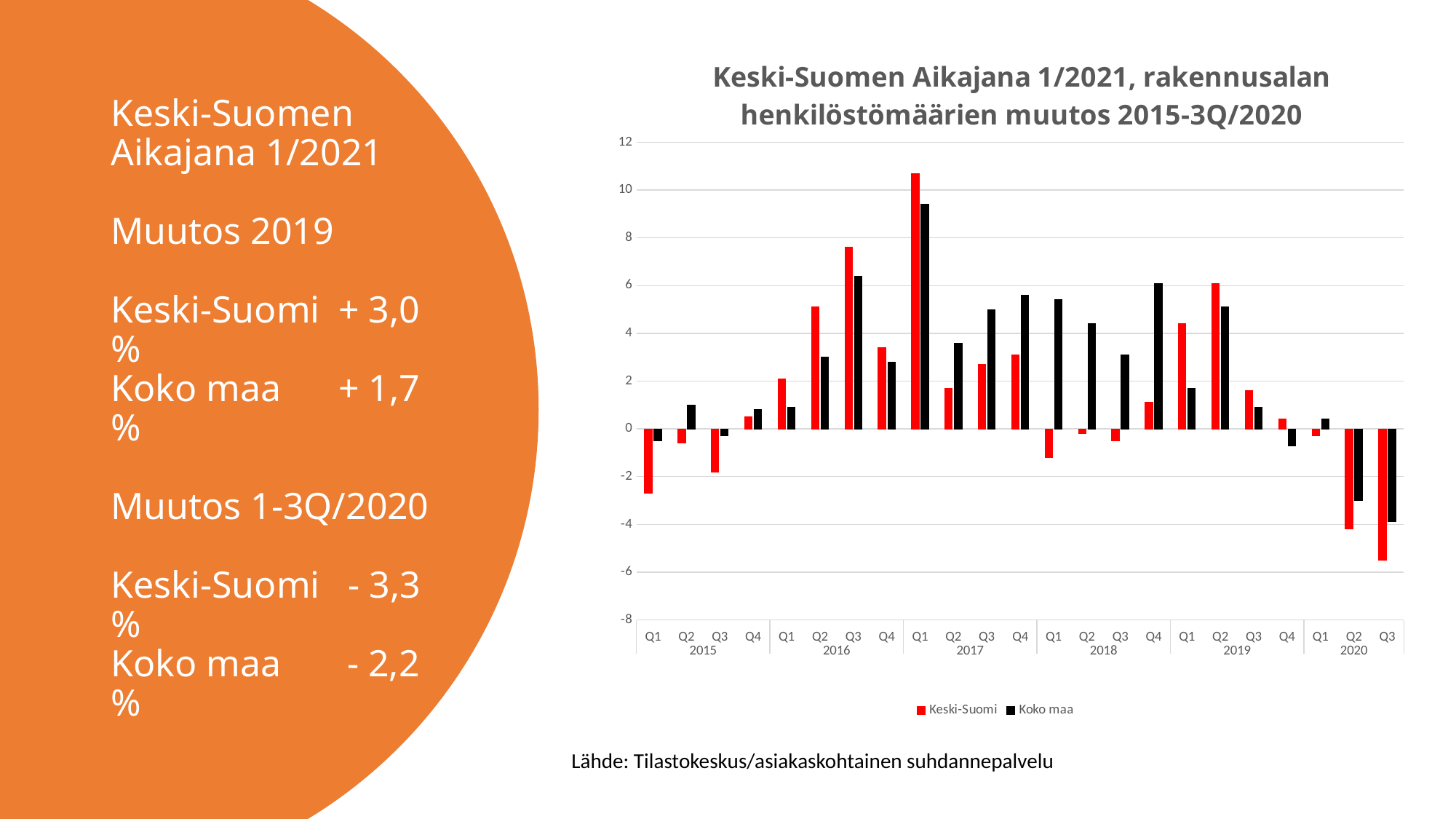
In Q1 2017, which series has the larger value, Keski-Suomi or Koko maa? Keski-Suomi Is the Keski-Suomi value for Q1 2017 greater or less than 10? greater How many quarters are plotted on the x axis of the chart? 23 Is the Keski-Suomi value for Q3 2020 greater or less than -4? less In which quarter does the Koko maa series reach its highest value? Q1 2017 In Q4 2018, which series has the larger value, Keski-Suomi or Koko maa? Koko maa In which quarter does the Keski-Suomi series reach its lowest value? Q3 2020 Which colour represents the Keski-Suomi series in the chart? red Is the Koko maa value for Q1 2017 greater or less than 8? greater In which quarter does the Keski-Suomi series reach its highest value? Q1 2017 What kind of chart is shown on the slide? bar chart How many series does the chart legend list? 2